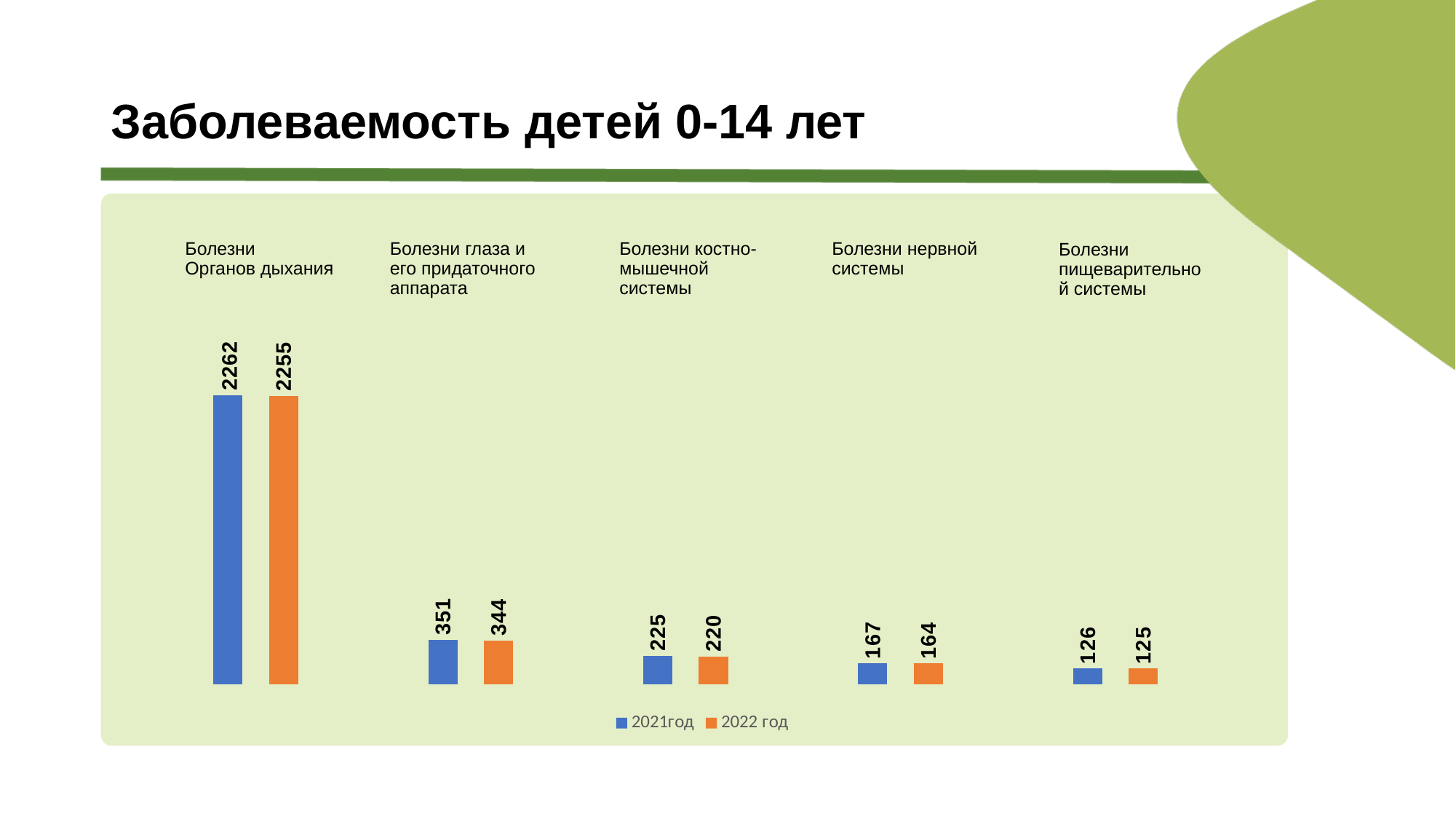
How many series does the legend list? 2 What is the value for Болезни пищеварительной системы in 2022 год? 125 What kind of chart is shown on the slide? Bar chart Which category has the highest value in 2022 год? Болезни органов дыхания What is the difference between the 2021год and 2022 год values for Болезни органов дыхания? 7 What is the value for Болезни глаза и его придаточного аппарата in 2022 год? 344 Which is larger for Болезни глаза и его придаточного аппарата: the 2021год value or the 2022 год value? 2021год What is the difference between the 2021год and 2022 год values for Болезни костно-мышечной системы? 5 What is the value for Болезни органов дыхания in 2021год? 2262 How many disease categories are shown on the chart? 5 Which category has the lowest value in 2021год? Болезни пищеварительной системы What is the value for Болезни нервной системы in 2021год? 167